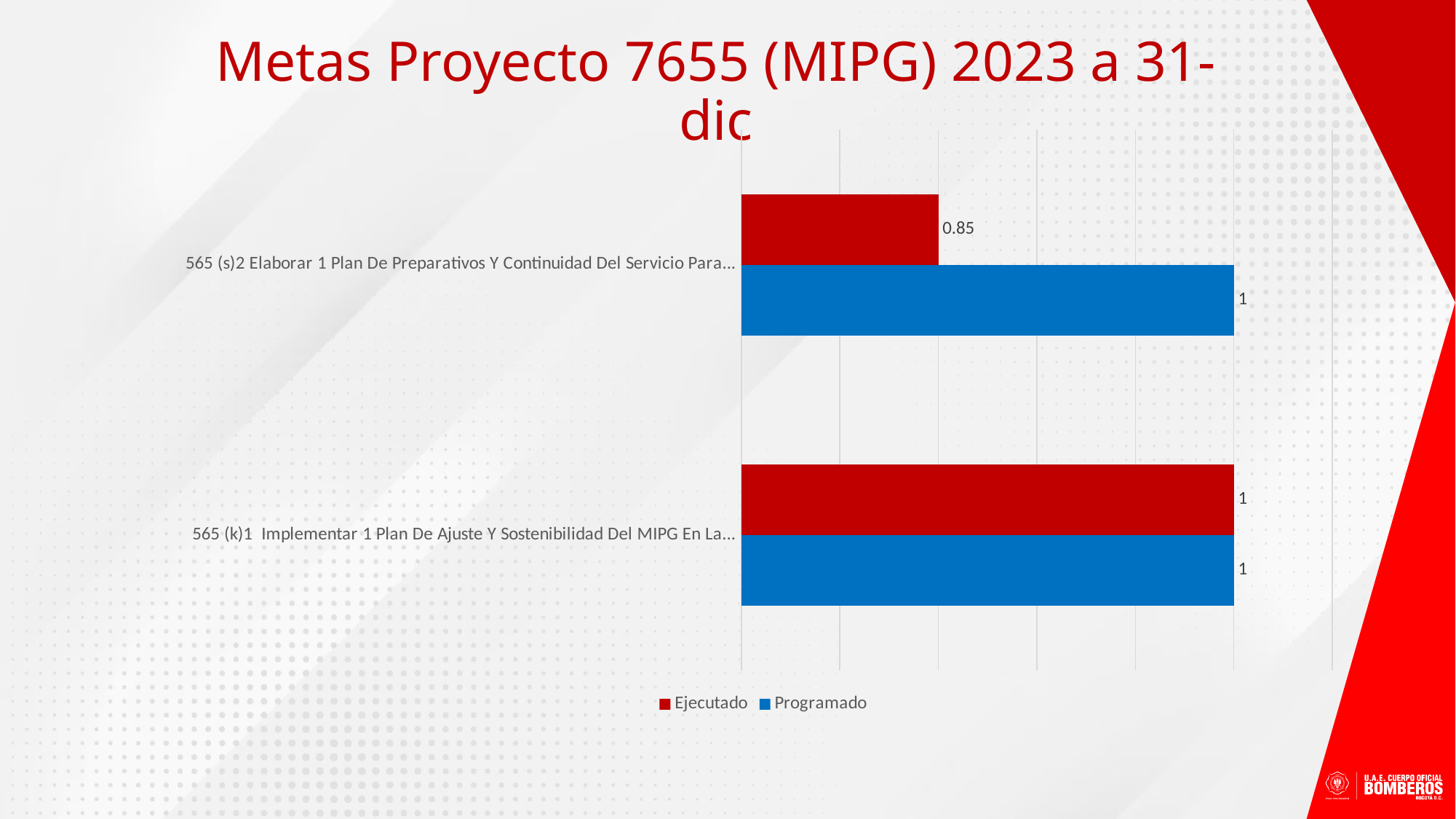
What is the difference between the Programado and Ejecutado values for '565 (s)2 Elaborar 1 Plan De Preparativos Y Continuidad Del Servicio Para...'? 0.15 What is the Programado value for the category '565 (k)1 Implementar 1 Plan De Ajuste Y Sostenibilidad Del MIPG En La...'? 1 What is the Ejecutado value for the category '565 (s)2 Elaborar 1 Plan De Preparativos Y Continuidad Del Servicio Para...'? 0.85 How many series does the legend list? 2 What is the title of the slide? Metas Proyecto 7655 (MIPG) 2023 a 31-dic Which colour represents the Programado series in the chart? Blue Which category has the lowest Ejecutado value? 565 (s)2 Elaborar 1 Plan De Preparativos Y Continuidad Del Servicio Para... For '565 (s)2 Elaborar 1 Plan De Preparativos Y Continuidad Del Servicio Para...', which is larger, Ejecutado or Programado? Programado What is the Programado value for the category '565 (s)2 Elaborar 1 Plan De Preparativos Y Continuidad Del Servicio Para...'? 1 What is the Ejecutado value for the category '565 (k)1 Implementar 1 Plan De Ajuste Y Sostenibilidad Del MIPG En La...'? 1 What kind of chart is shown on the slide? Bar chart How many categories are shown in the chart? 2